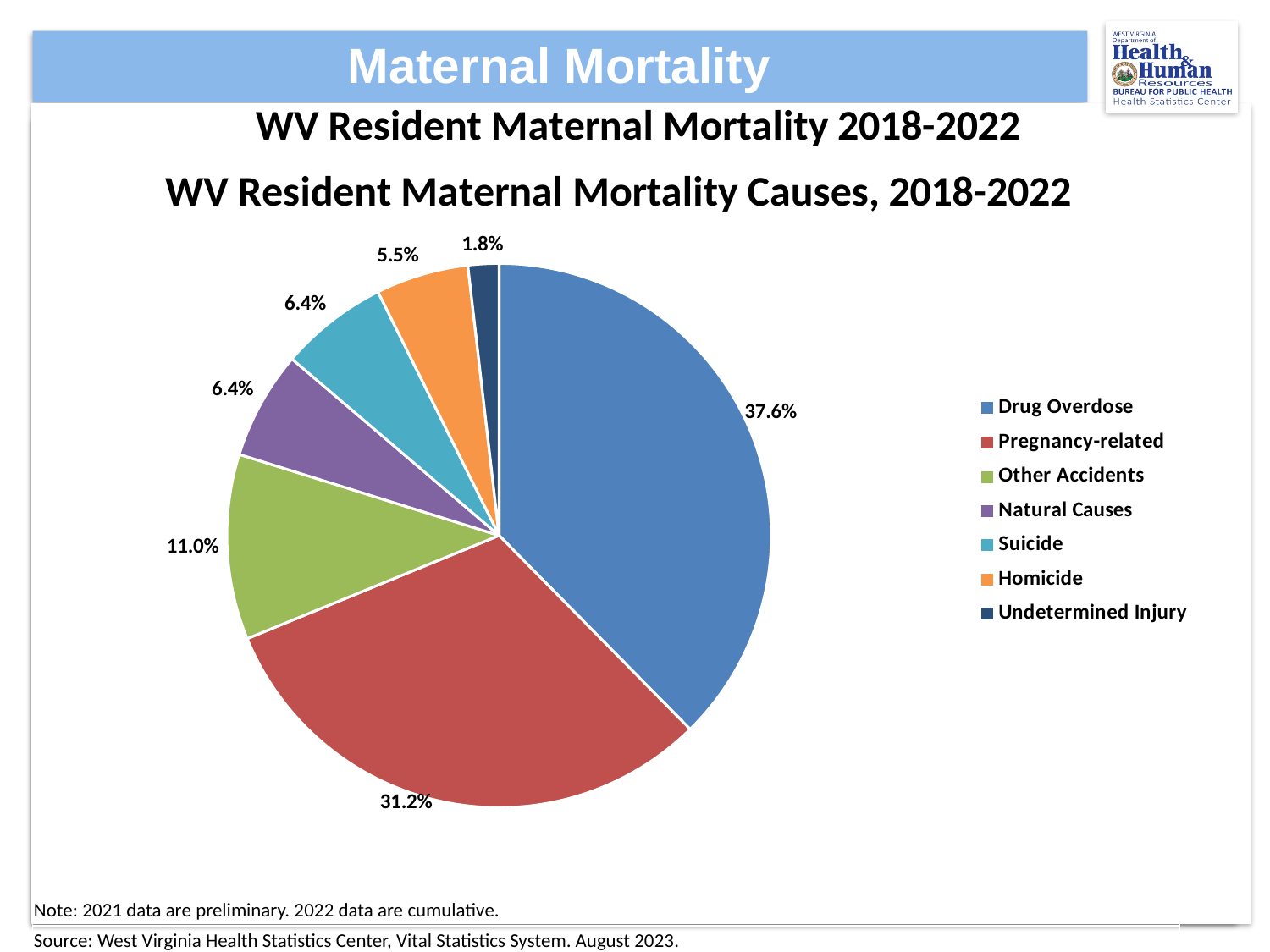
Which cause has the largest share of the pie? Drug Overdose Which cause has the smallest share of the pie? Undetermined Injury What is the difference in percentage points between Drug Overdose and Pregnancy-related? 6.4 How many causes are listed in the legend? 7 What colour represents Suicide in the pie chart? Light blue What percentage of the pie is Pregnancy-related? 31.2% What percentage is shown for Homicide? 5.5% What share of WV resident maternal mortality causes, 2018-2022, is Drug Overdose? 37.6% What share does Other Accidents account for? 11.0% Which is larger, the share for Other Accidents or the share for Homicide? Other Accidents What percentage is shown for Undetermined Injury? 1.8% What type of chart is shown on the slide? Pie chart